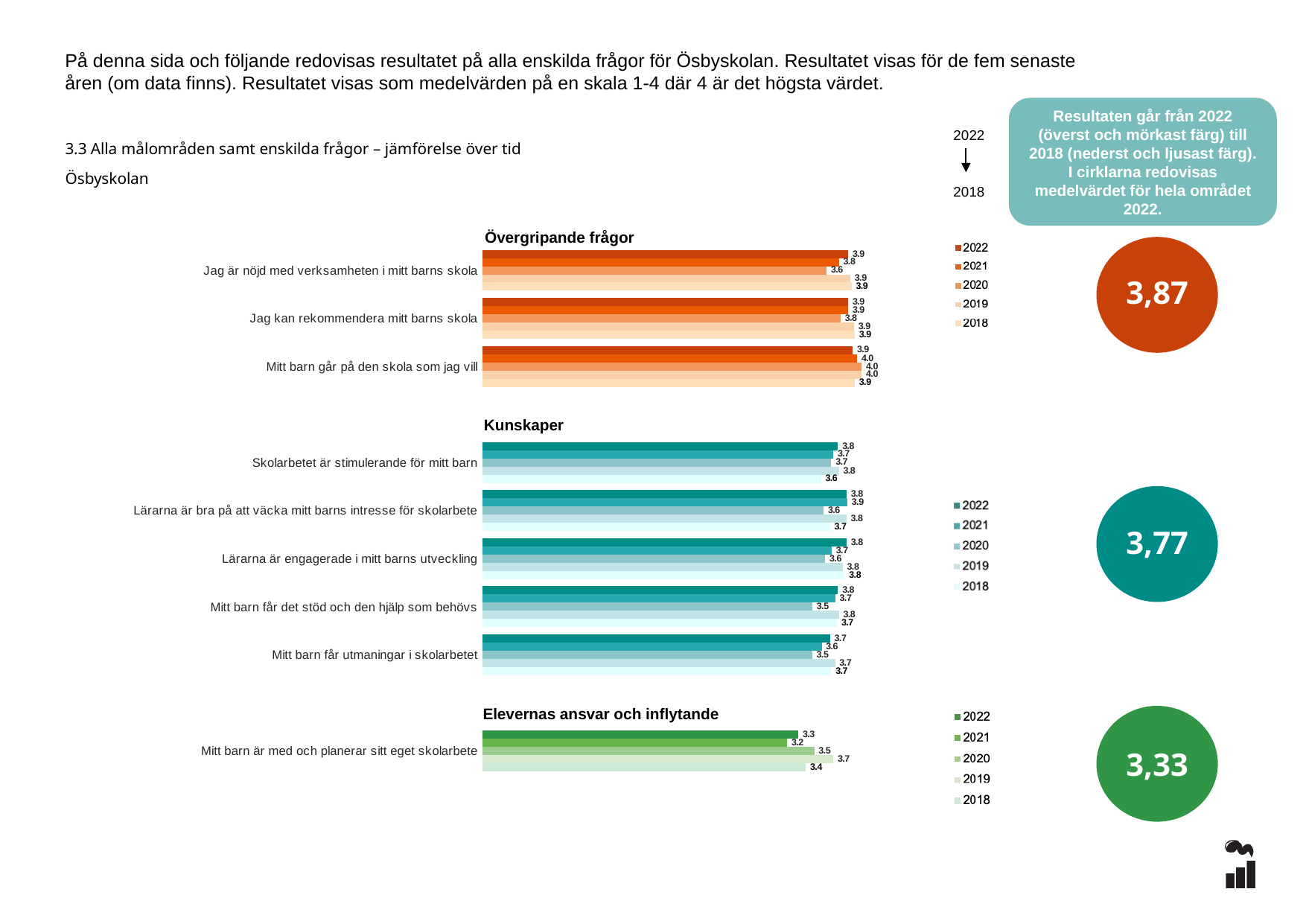
In the 'Övergripande frågor' chart, what is the 2022 value for 'Jag är nöjd med verksamheten i mitt barns skola'? 3.9 In the 'Elevernas ansvar och inflytande' chart, which year has the highest value for 'Mitt barn är med och planerar sitt eget skolarbete'? 2019 In the 'Elevernas ansvar och inflytande' chart, what is the difference between the 2019 and 2022 values for 'Mitt barn är med och planerar sitt eget skolarbete'? 0.4 In the 'Elevernas ansvar och inflytande' chart, which year has the lowest value for 'Mitt barn är med och planerar sitt eget skolarbete'? 2021 What type of chart is used for 'Kunskaper'? Bar chart In the 'Kunskaper' chart, what is the 2020 value for 'Mitt barn får det stöd och den hjälp som behövs'? 3.5 How many series does the legend of the 'Övergripande frågor' chart list? 5 In the 'Kunskaper' chart, what is the 2021 value for 'Lärarna är bra på att väcka mitt barns intresse för skolarbete'? 3.9 In the 'Kunskaper' chart, which is larger for 'Mitt barn får utmaningar i skolarbetet': the 2022 value or the 2020 value? 2022 How many questions (categories) are shown in the 'Kunskaper' chart? 5 In the 'Övergripande frågor' chart, what is the 2021 value for 'Mitt barn går på den skola som jag vill'? 4.0 In the 'Övergripande frågor' chart, what is the 2020 value for 'Jag är nöjd med verksamheten i mitt barns skola'? 3.6